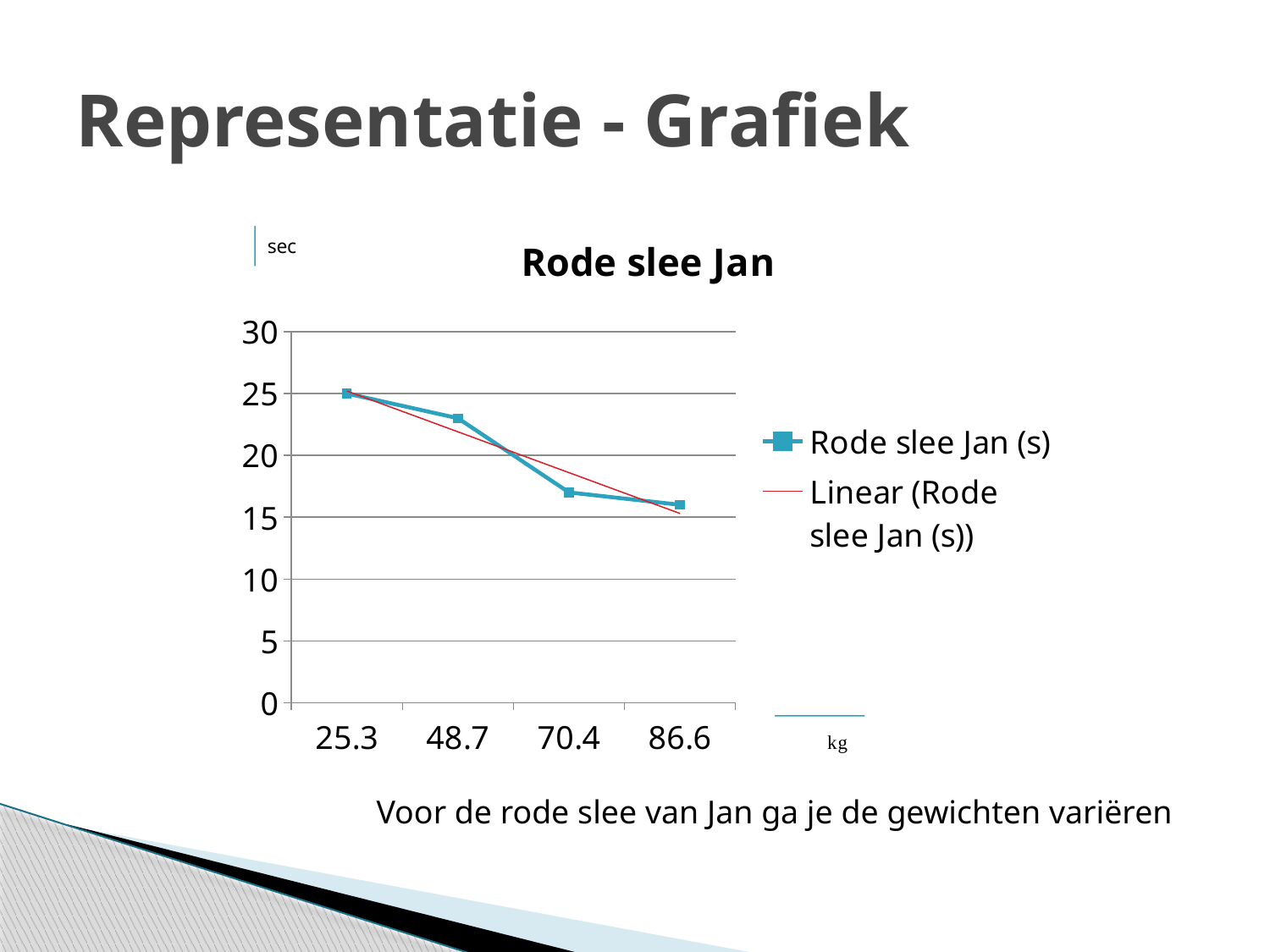
Which is larger in the Rode slee Jan (s) series, the value for 48.7 or the value for 70.4? 48.7 What unit is labelled on the x axis of the chart? kg Is the value for 70.4 greater or less than 20? less Do the values of the Rode slee Jan (s) series rise or fall as the weight increases along the x axis? fall Which weight has the highest value in the Rode slee Jan (s) series? 25.3 Is the value for 48.7 greater or less than 20? greater Is the value for 86.6 greater or less than 20? less What is the title of the chart? Rode slee Jan How many data points are plotted for the Rode slee Jan (s) series? 4 What is the value for 25.3 kg in the Rode slee Jan (s) series? 25 What kind of chart is shown on the slide? line chart How many entries does the legend list? 2